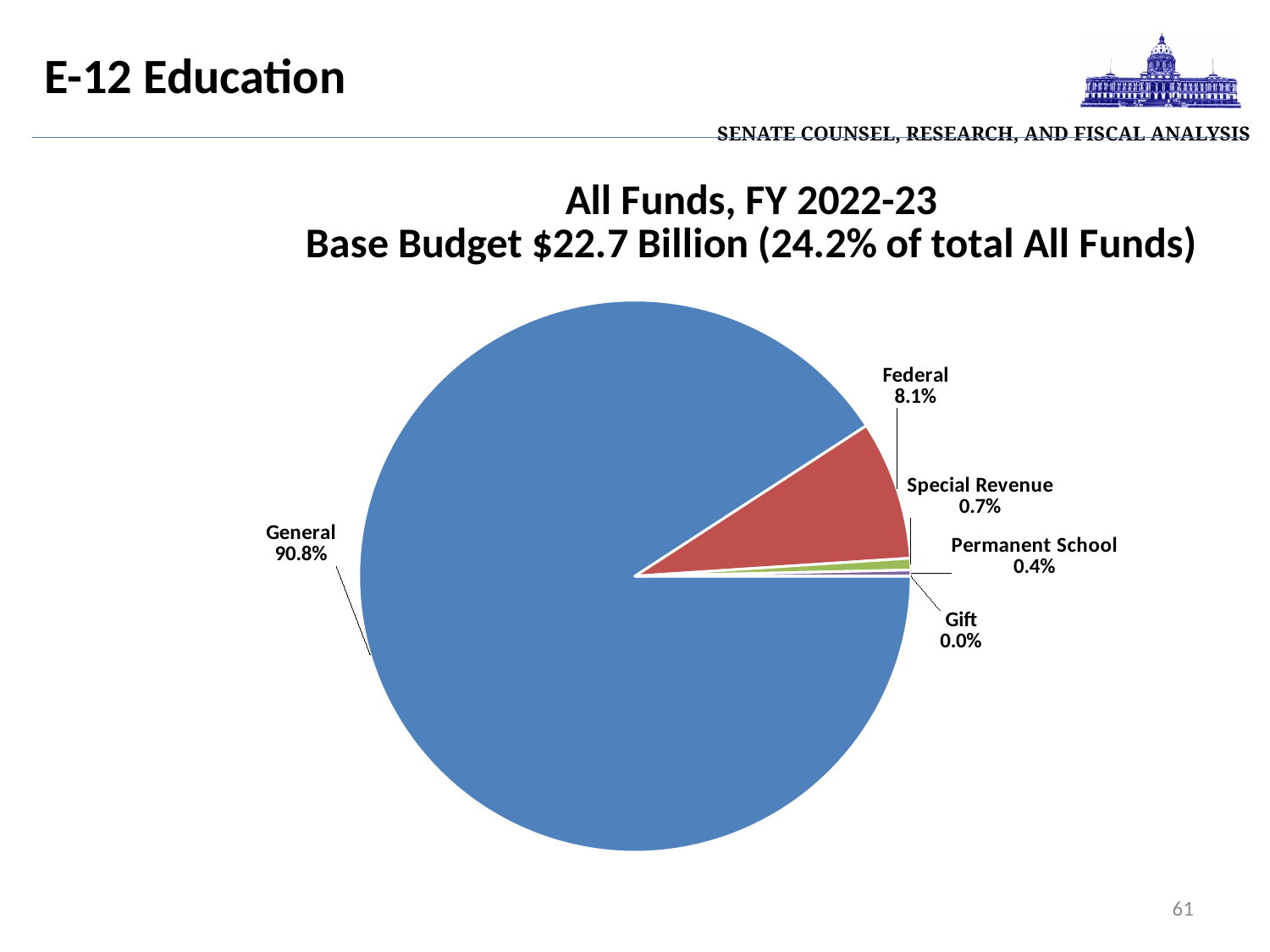
What share of the pie does the General fund account for? 90.8% What is the value shown for Special Revenue? 0.7% Which category has the smallest slice of the pie? Gift Which is larger, Special Revenue or Permanent School? Special Revenue What is the title of the chart? All Funds, FY 2022-23 Base Budget $22.7 Billion (24.2% of total All Funds) What is the value shown for Permanent School? 0.4% How many categories are shown in the pie chart? 5 What kind of chart is shown on the slide? Pie chart What is the value shown for Gift? 0.0% What is the difference between the General and Federal shares? 82.7% What is the value shown for Federal? 8.1% Which category has the largest slice of the pie? General